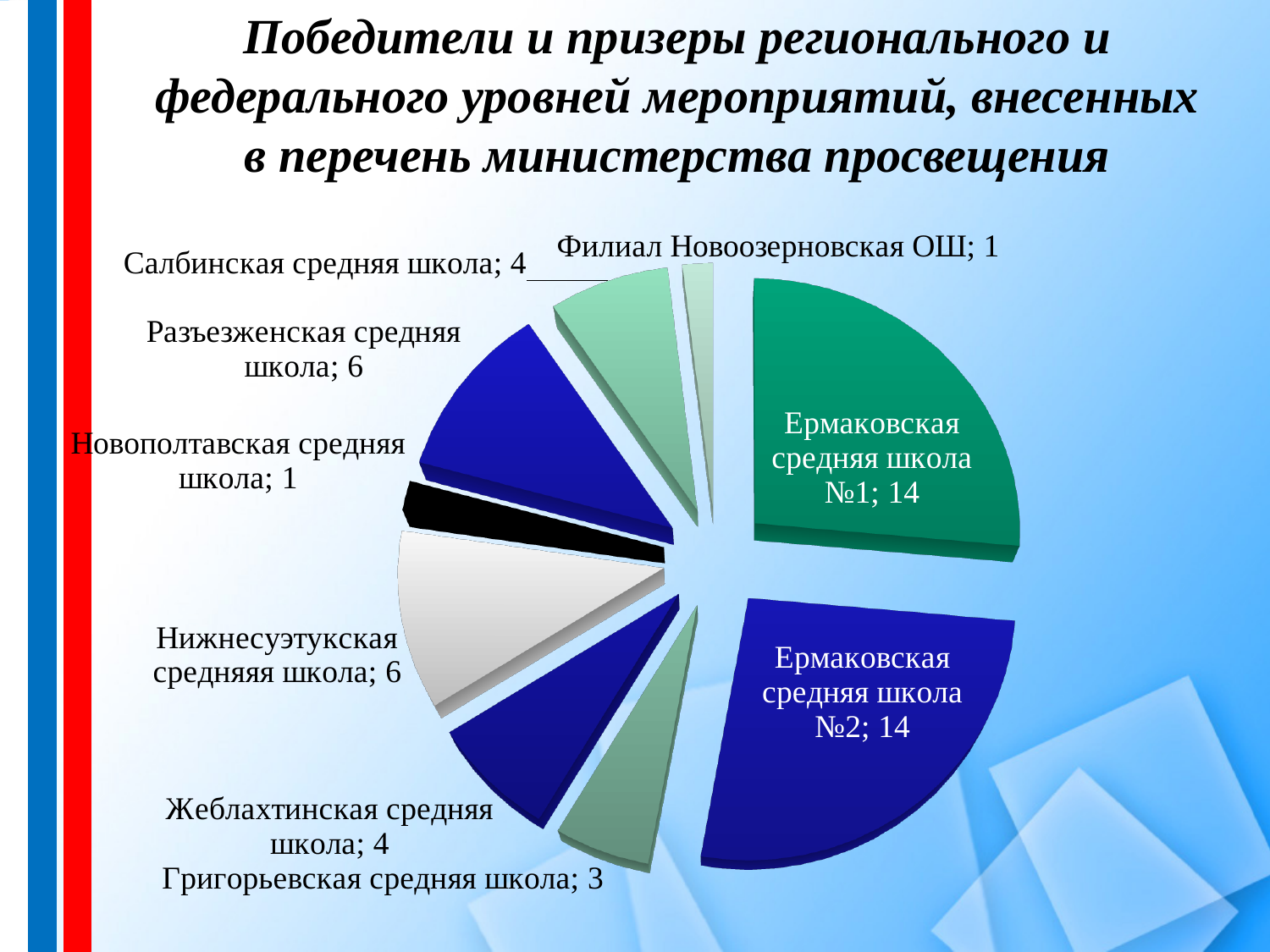
Which has a larger value, Жеблахтинская средняя школа or Нижнесуэтукская средняяя школа? Нижнесуэтукская средняяя школа What kind of chart is shown on the slide? pie chart What is the value for Нижнесуэтукская средняяя школа? 6 What is the value for Филиал Новоозерновская ОШ? 1 What is the largest value shown in the pie chart? 14 What is the value for Ермаковская средняя школа №1? 14 What is the smallest value shown in the pie chart? 1 What is the title of the slide containing the pie chart? Победители и призеры регионального и федерального уровней мероприятий, внесенных в перечень министерства просвещения What is the difference between the values for Ермаковская средняя школа №2 and Разъезженская средняя школа? 8 What is the total of all values in the pie chart? 53 What is the value for Григорьевская средняя школа? 3 How many slices does the pie chart have? 9